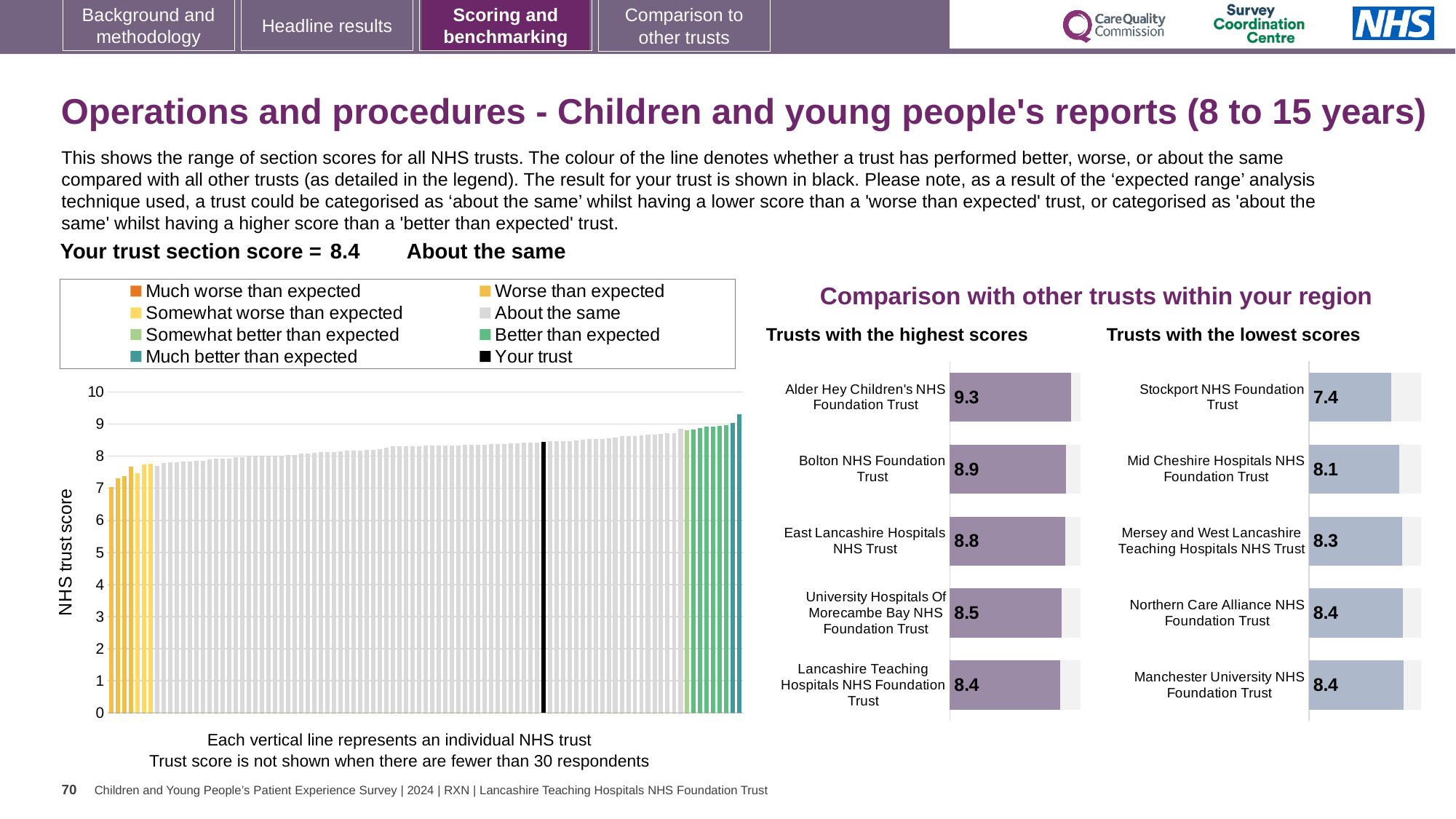
What kind of chart is the large chart on the left showing NHS trust scores? Bar chart In the 'Trusts with the lowest scores' chart, what is the difference between the scores of Mid Cheshire Hospitals NHS Foundation Trust and Stockport NHS Foundation Trust? 0.7 In the 'Trusts with the highest scores' chart, which has the larger score: East Lancashire Hospitals NHS Trust or University Hospitals Of Morecambe Bay NHS Foundation Trust? East Lancashire Hospitals NHS Trust In the 'Trusts with the lowest scores' chart, what is the score for Stockport NHS Foundation Trust? 7.4 In the 'Trusts with the highest scores' chart, what is the difference between the scores of Alder Hey Children's NHS Foundation Trust and Bolton NHS Foundation Trust? 0.4 In the 'Trusts with the highest scores' chart, what is the score for Alder Hey Children's NHS Foundation Trust? 9.3 In the 'Trusts with the highest scores' chart, which trust has the highest score? Alder Hey Children's NHS Foundation Trust In the 'Trusts with the lowest scores' chart, what is the score for Mid Cheshire Hospitals NHS Foundation Trust? 8.1 How many trusts are shown in the 'Trusts with the highest scores' chart? 5 In the left-hand chart, is the value of the black bar for your trust greater or less than 8? greater In the 'Trusts with the lowest scores' chart, which trust has the lowest score? Stockport NHS Foundation Trust How many entries does the legend of the left-hand NHS trust score chart list? 8